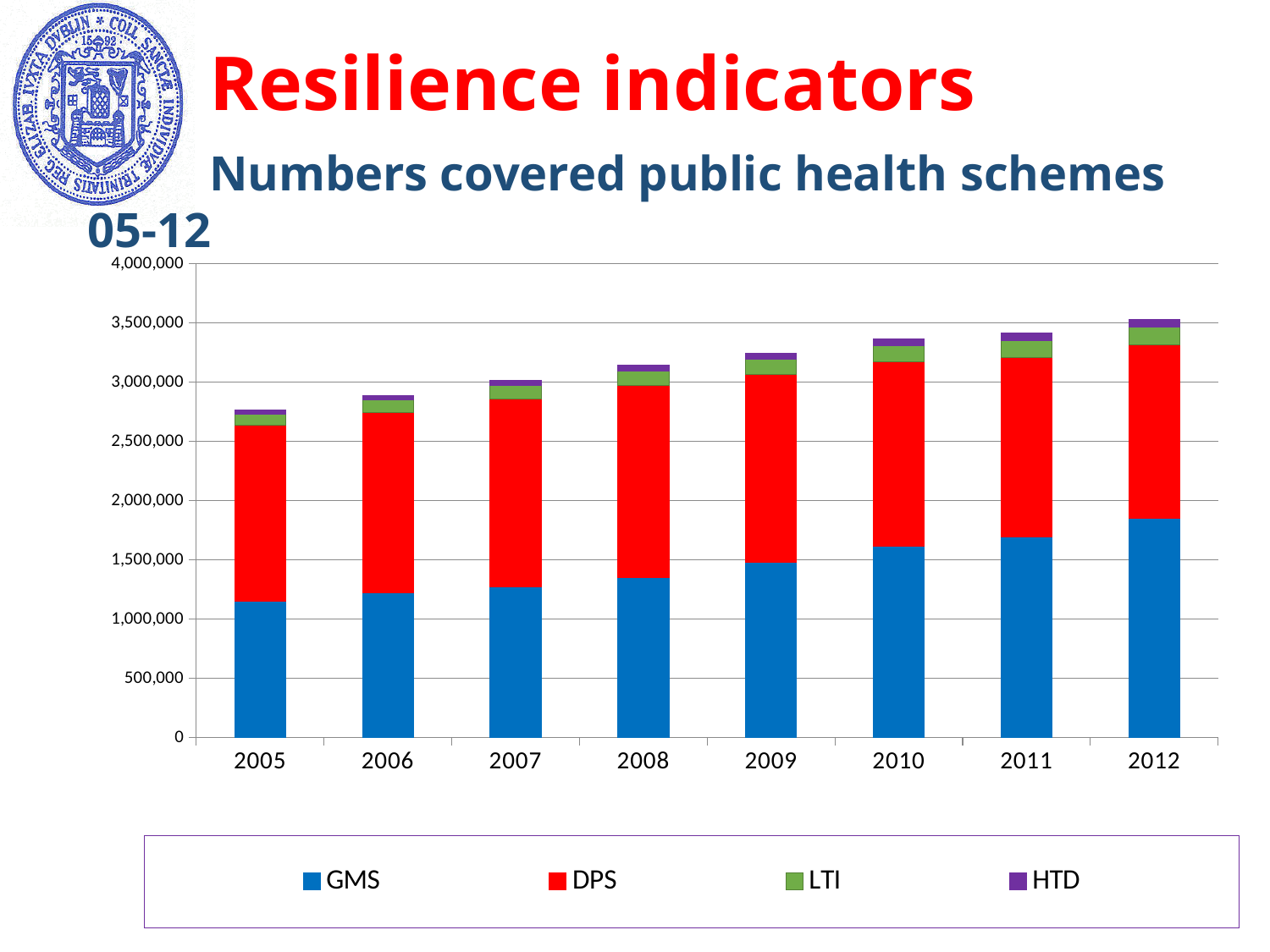
How many series does the chart's legend list? 4 Is the GMS value for 2012 greater or less than 2,000,000? less In which year is the total stacked bar the tallest? 2012 How many years are shown on the x axis of the chart? 8 Which colour represents the GMS series in the chart? Blue Does the total height of the stacked bars rise or fall from 2005 to 2012? Rise What kind of chart is shown on the slide? Stacked bar chart Which series are listed in the chart's legend? GMS, DPS, LTI, HTD In which year is the total stacked bar the shortest? 2005 Is the GMS value for 2005 greater or less than 1,000,000? greater Is the total stacked bar for 2005 greater or less than 3,000,000? less Which is larger in 2005, the GMS segment or the DPS segment? DPS